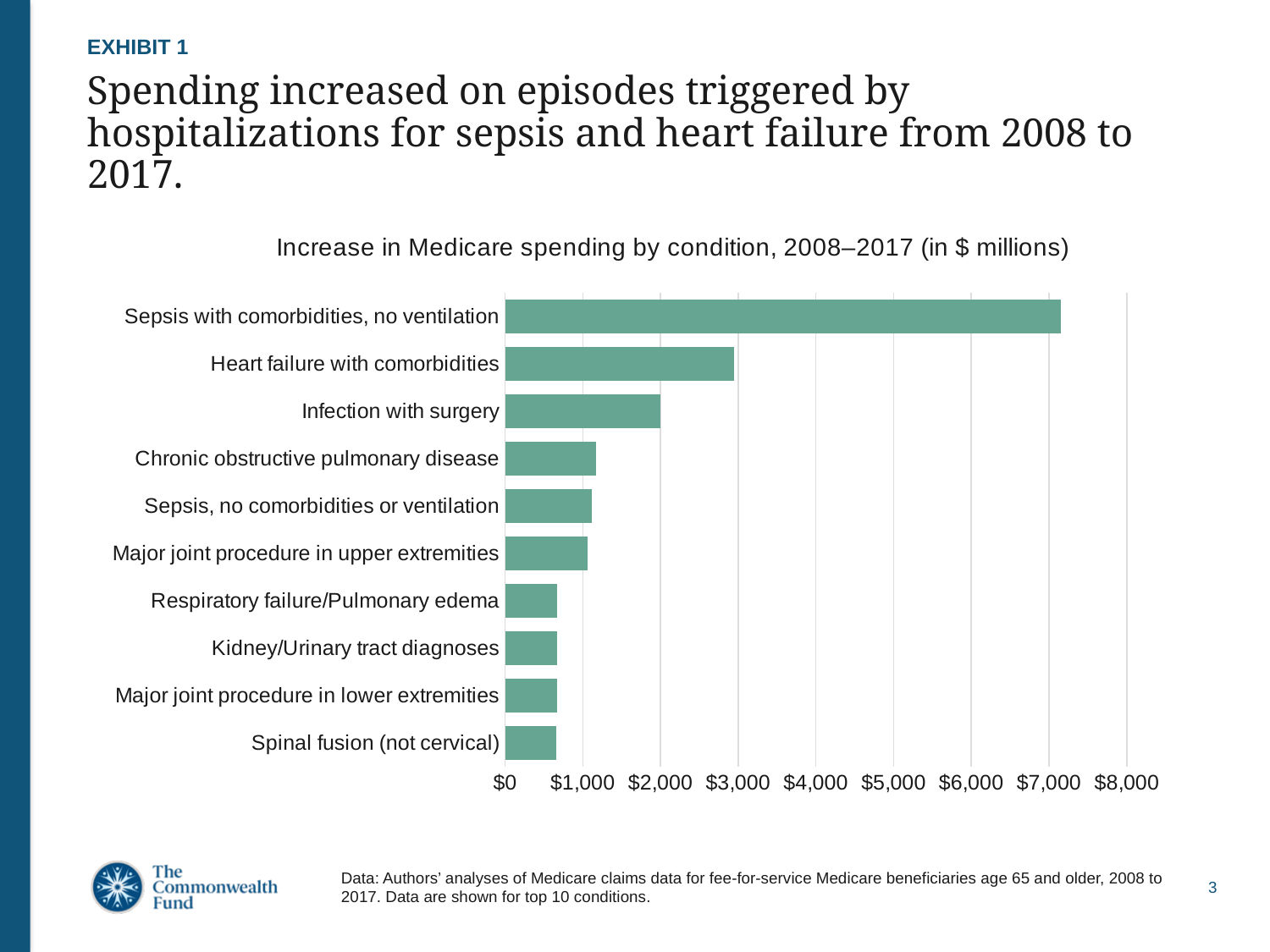
Is the value for Sepsis with comorbidities, no ventilation greater or less than $6,000? greater What is the title of the chart? Increase in Medicare spending by condition, 2008–2017 (in $ millions) What kind of chart is shown on the slide? Bar chart Is the value for Heart failure with comorbidities greater or less than $2,000? greater Which has a larger increase in spending: Sepsis with comorbidities, no ventilation or Heart failure with comorbidities? Sepsis with comorbidities, no ventilation Which condition has the largest increase in Medicare spending? Sepsis with comorbidities, no ventilation Is the value for Spinal fusion (not cervical) greater or less than $1,000? less What is the highest value shown on the horizontal axis? $8,000 How many conditions are shown in the chart? 10 Which has a larger increase in spending: Heart failure with comorbidities or Infection with surgery? Heart failure with comorbidities